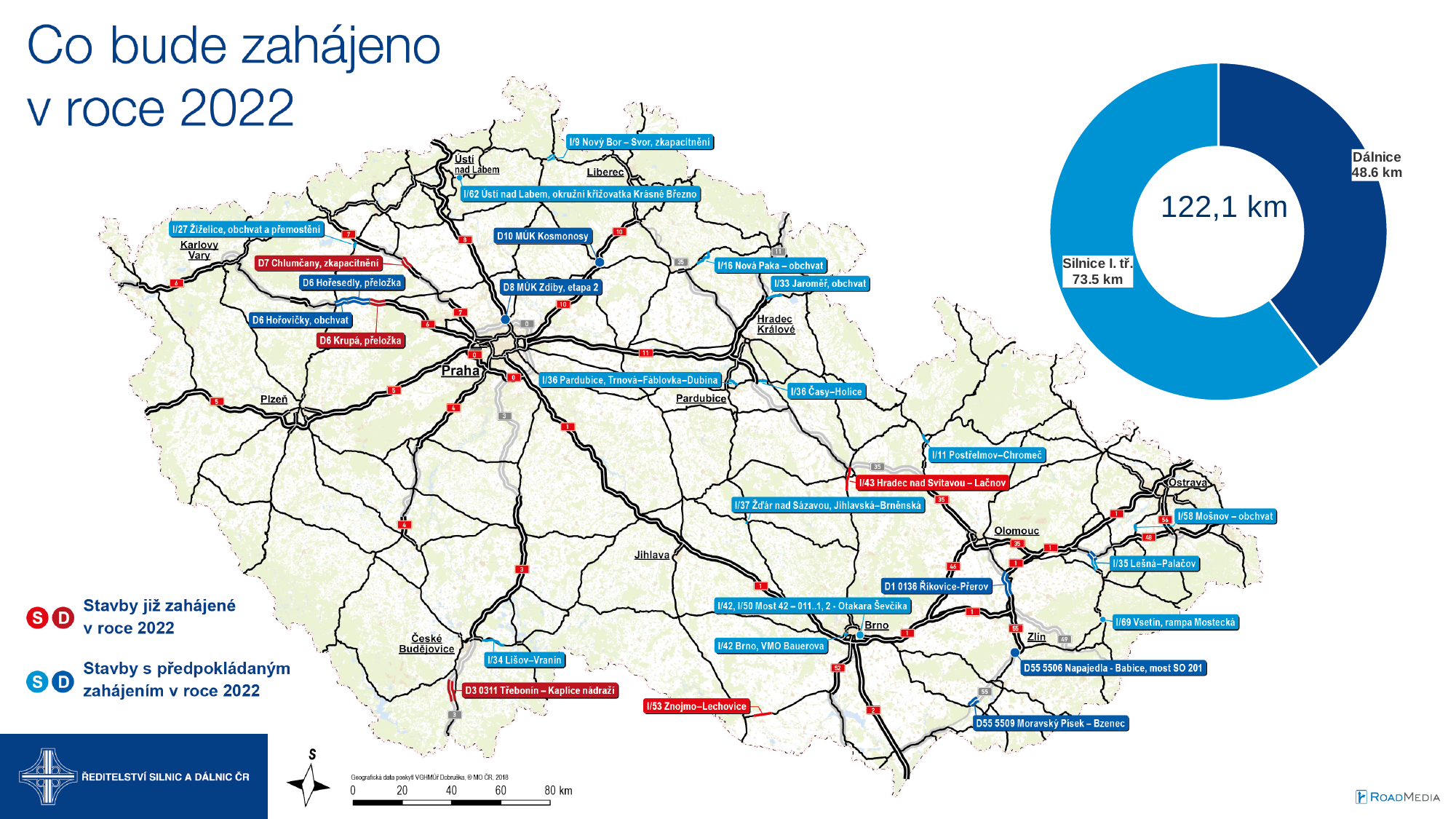
Which slice of the donut chart is drawn in light blue? Silnice I. tř. What kind of chart is shown on the right of the slide? Donut (pie) chart In the donut chart, what is the value for Silnice I. tř.? 73.5 km What total value is printed in the centre of the donut chart? 122,1 km In the donut chart, what is the value for Dálnice? 48.6 km How many categories (slices) does the donut chart have? 2 Which category in the donut chart has the larger value? Silnice I. tř. In the donut chart, is the value for Silnice I. tř. larger or smaller than the value for Dálnice? larger Which slice of the donut chart is drawn in dark blue? Dálnice Which category in the donut chart has the smaller value? Dálnice What is the difference between the Silnice I. tř. value and the Dálnice value in the donut chart? 24.9 km